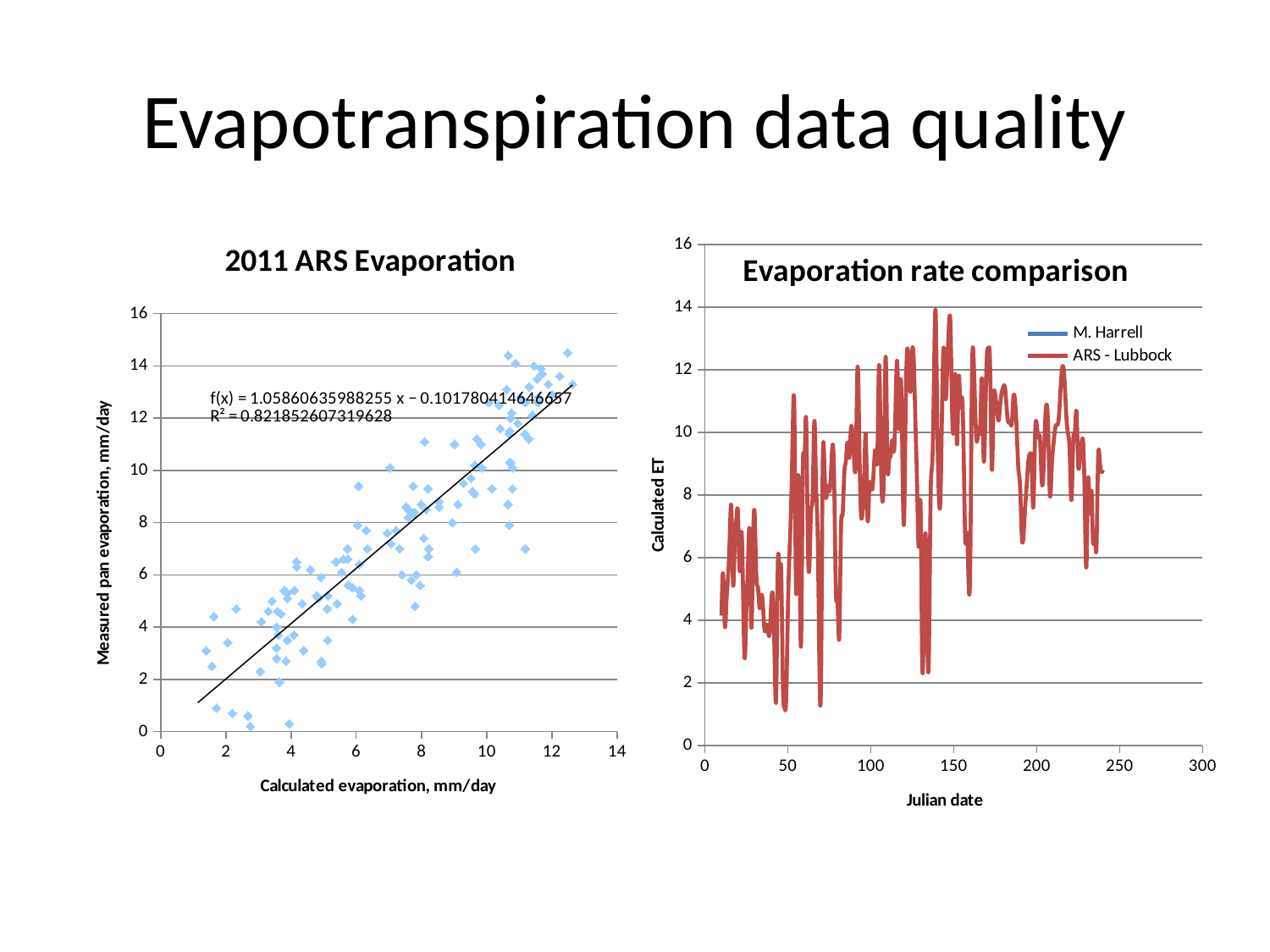
In the 'Evaporation rate comparison' chart, what are the two series named in the legend? M. Harrell and ARS - Lubbock What is the x-axis label of the 'Evaporation rate comparison' chart? Julian date In the '2011 ARS Evaporation' chart, is the value of the intercept in the printed trendline equation greater or less than 0? less What kind of chart is the '2011 ARS Evaporation' chart on the left? scatter chart In the 'Evaporation rate comparison' chart, is the highest value reached by the ARS - Lubbock series greater or less than 12? greater In the '2011 ARS Evaporation' chart, what R² value is printed for the trendline? 0.821852607319628 In the 'Evaporation rate comparison' chart, how many series does the legend list? 2 In the 'Evaporation rate comparison' chart, is the lowest value reached by the ARS - Lubbock series greater or less than 2? less What kind of chart is the 'Evaporation rate comparison' chart on the right? line chart In the '2011 ARS Evaporation' chart, does measured pan evaporation rise or fall as calculated evaporation increases? rise In the '2011 ARS Evaporation' chart, what is the slope (coefficient of x) in the printed trendline equation? 1.05860635988255 In the 'Evaporation rate comparison' chart, do the ARS - Lubbock values generally rise or fall between Julian date 0 and Julian date 100? rise